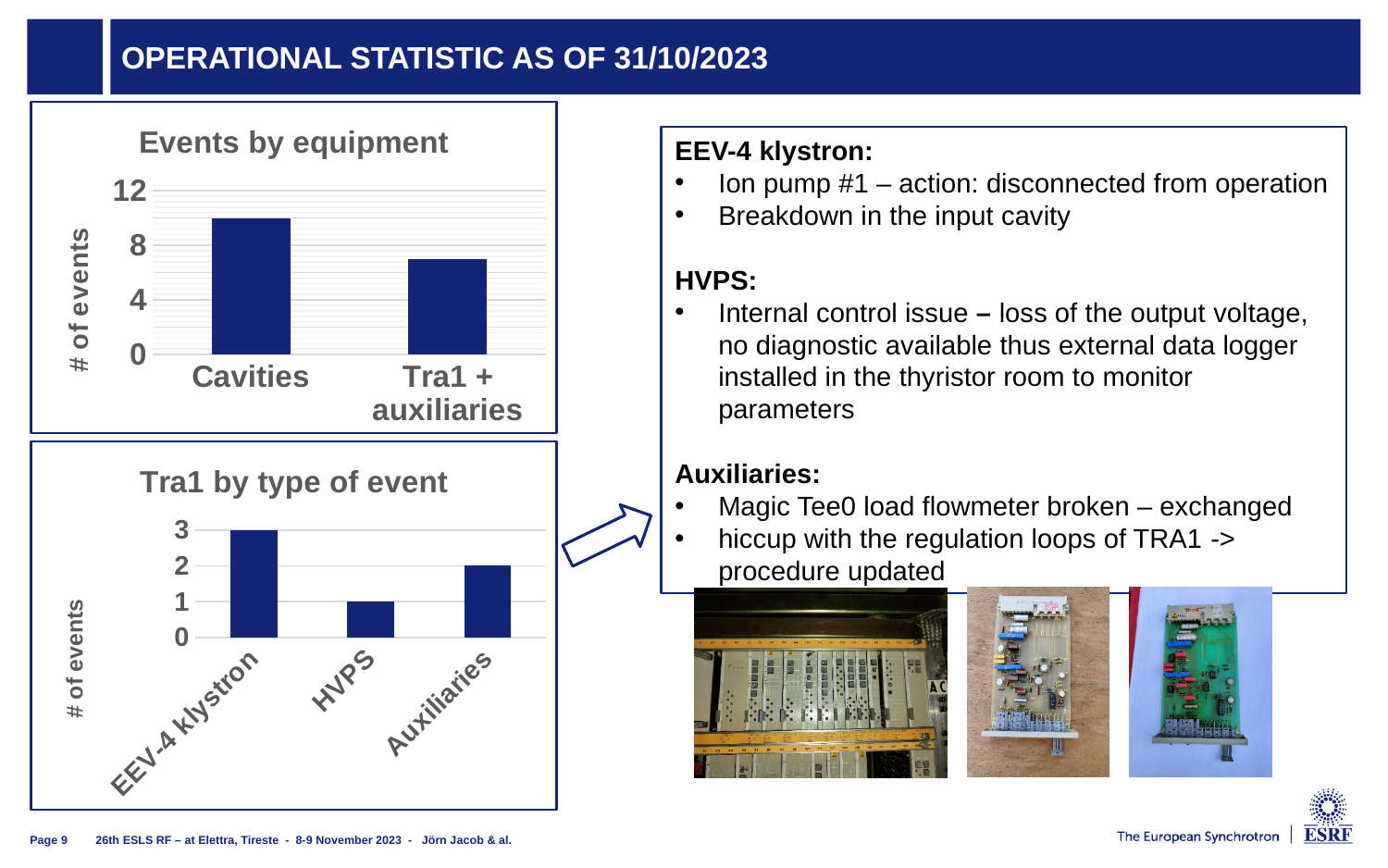
In the 'Tra1 by type of event' chart, which type of event has the lowest number of events? HVPS What is the y-axis label of the 'Tra1 by type of event' chart? # of events In the 'Tra1 by type of event' chart, which has more events, Auxiliaries or HVPS? Auxiliaries What type of chart is 'Events by equipment'? bar chart In the 'Tra1 by type of event' chart, what is the difference in events between EEV-4 klystron and HVPS? 2 In the 'Events by equipment' chart, is the value for Cavities greater or less than 8? greater In the 'Events by equipment' chart, how many categories are shown? 2 In the 'Tra1 by type of event' chart, how many events are shown for HVPS? 1 In the 'Tra1 by type of event' chart, how many events are shown for Auxiliaries? 2 In the 'Events by equipment' chart, is the value for Tra1 + auxiliaries greater or less than 8? less In the 'Tra1 by type of event' chart, how many events are shown for EEV-4 klystron? 3 In the 'Events by equipment' chart, which category has the highest number of events? Cavities